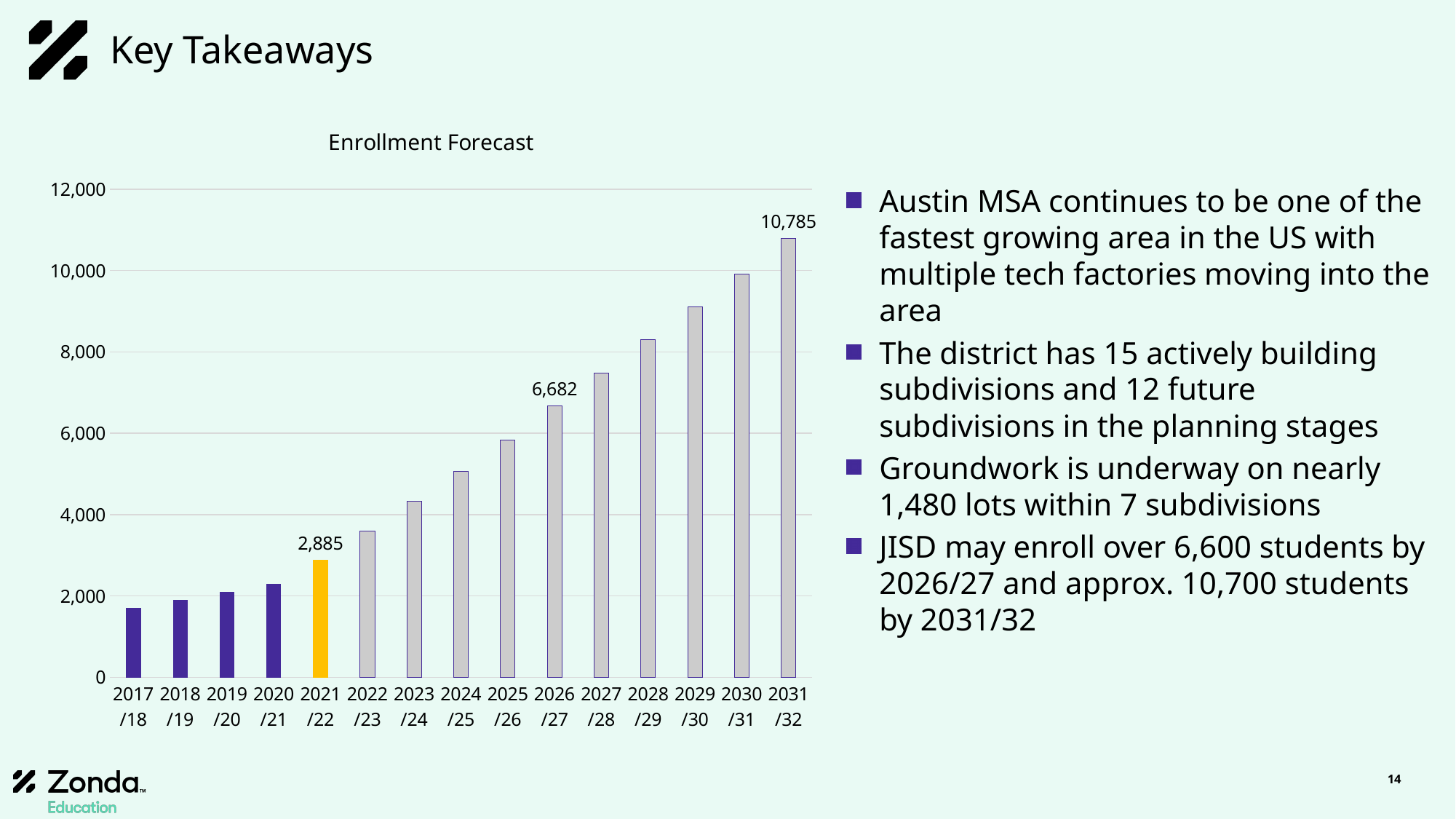
What is the difference between the enrollment for 2031/32 and 2026/27? 4,103 Which year has the highest enrollment in the chart? 2031/32 What is the difference between the enrollment for 2026/27 and 2021/22? 3,797 Is the value for 2022/23 greater or less than 4,000? less What kind of chart is shown on the slide? Bar chart What is the enrollment value shown for 2026/27? 6,682 How many years are shown on the x axis of the chart? 15 Is the value for 2029/30 greater or less than 8,000? greater Which is larger, the enrollment for 2024/25 or 2028/29? 2028/29 Which year has the lowest enrollment in the chart? 2017/18 What is the enrollment value shown for 2031/32? 10,785 What is the enrollment value shown for 2021/22? 2,885